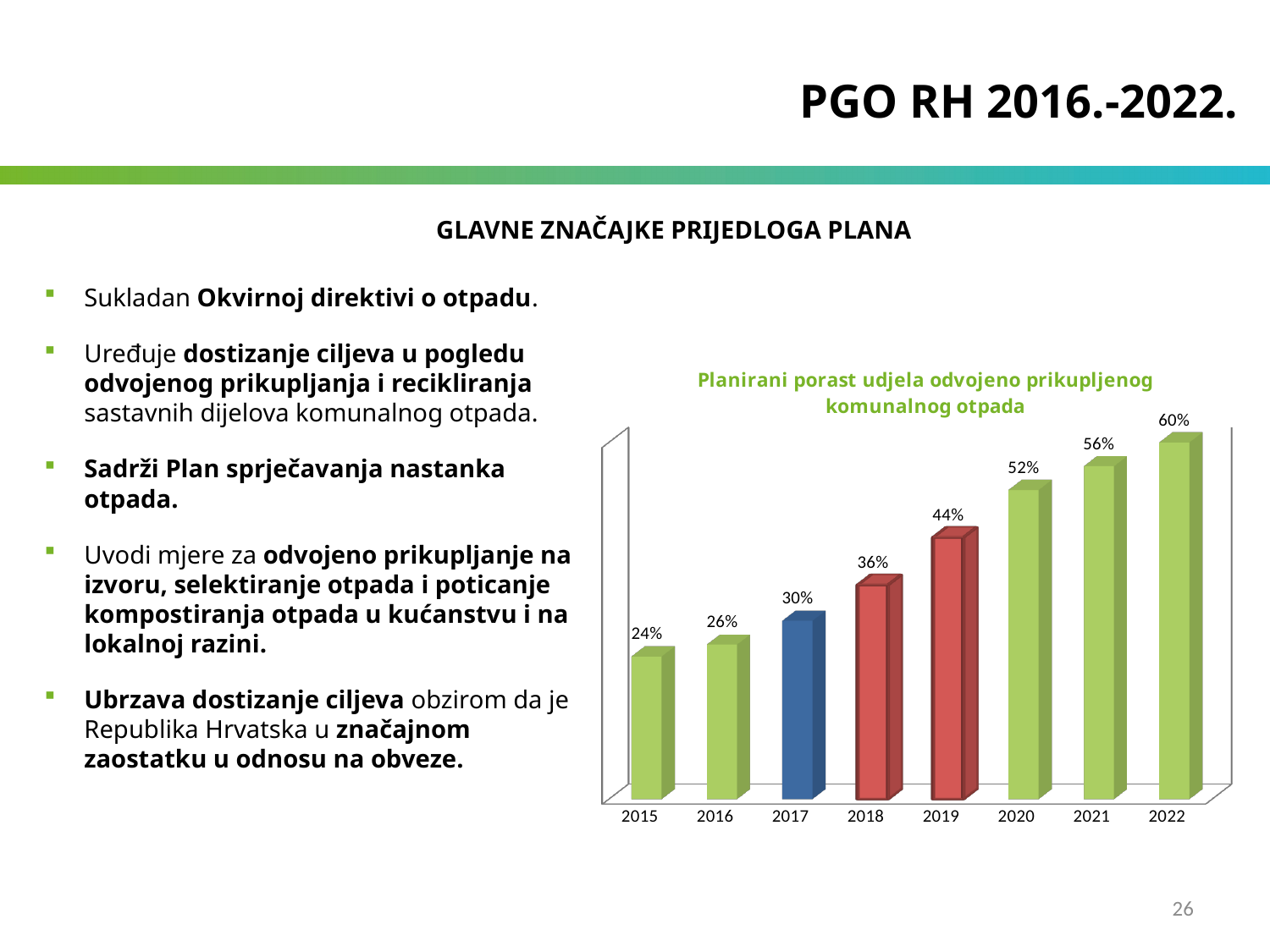
Which year has the highest value in the chart? 2022 How many years are shown on the x axis of the chart? 8 What kind of chart is shown on the slide? Bar chart Which year has the lowest value in the chart? 2015 Do the values rise or fall from 2015 to 2022? Rise What is the difference between the values for 2018 and 2017? 6% What is the difference between the values for 2022 and 2015? 36% What value is shown for 2021 in the chart? 56% What value is shown for 2015 in the chart? 24% What is the planned share of separately collected municipal waste for 2019? 44% What is the title of the chart? Planirani porast udjela odvojeno prikupljenog komunalnog otpada Which year has a larger value, 2018 or 2020? 2020